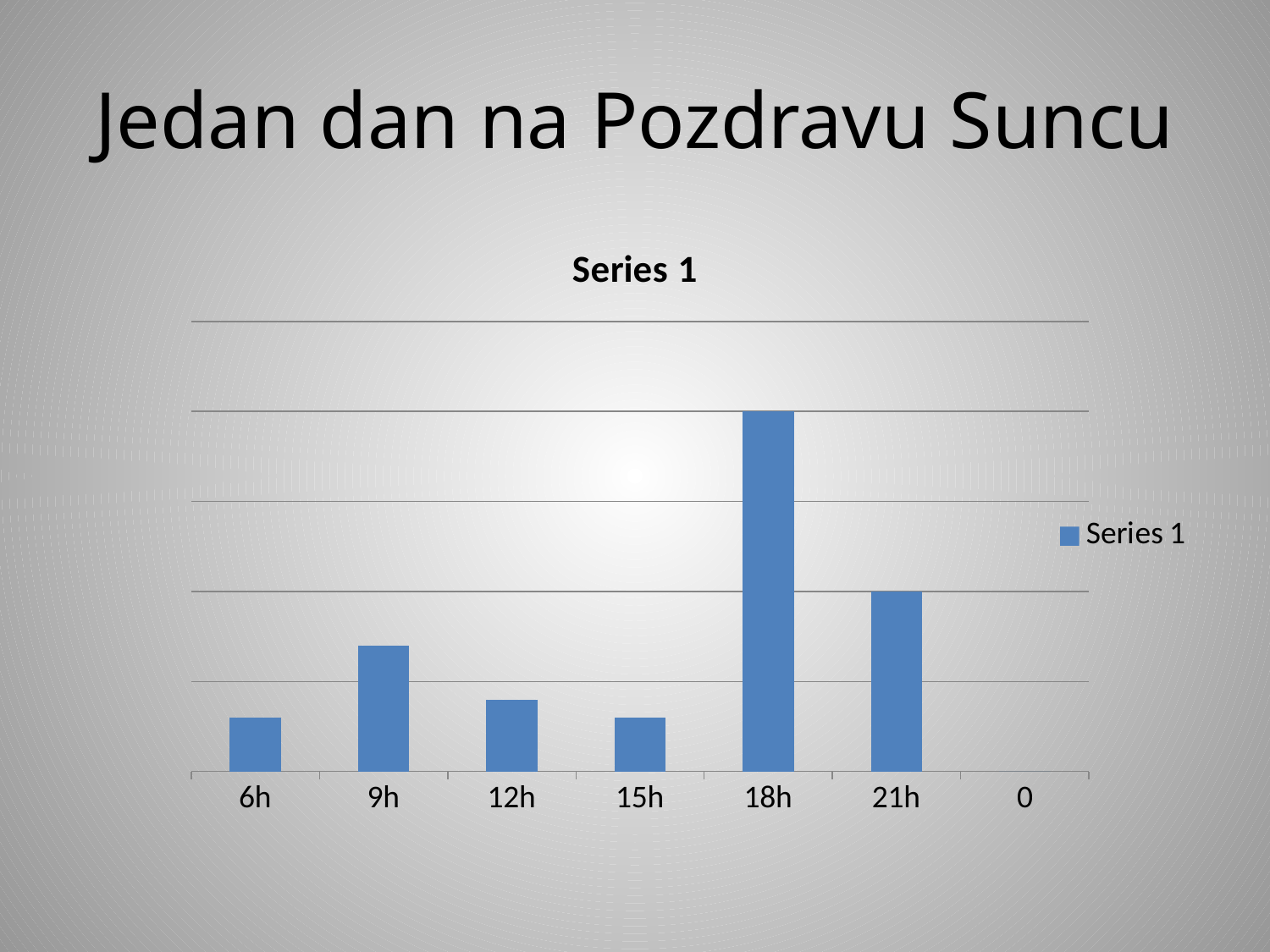
Which is larger, the value for 9h or the value for 12h? 9h Which category has the highest bar? 18h Which is larger, the value for 21h or the value for 9h? 21h Which category has the second highest bar? 21h What is the title of the chart? Series 1 How many series does the legend list? 1 Which is larger, the value for 12h or the value for 15h? 12h How many category labels are shown on the x axis? 7 How many bars are plotted in the chart? 6 What type of chart is shown on the slide? bar chart What is the title of the slide? Jedan dan na Pozdravu Suncu